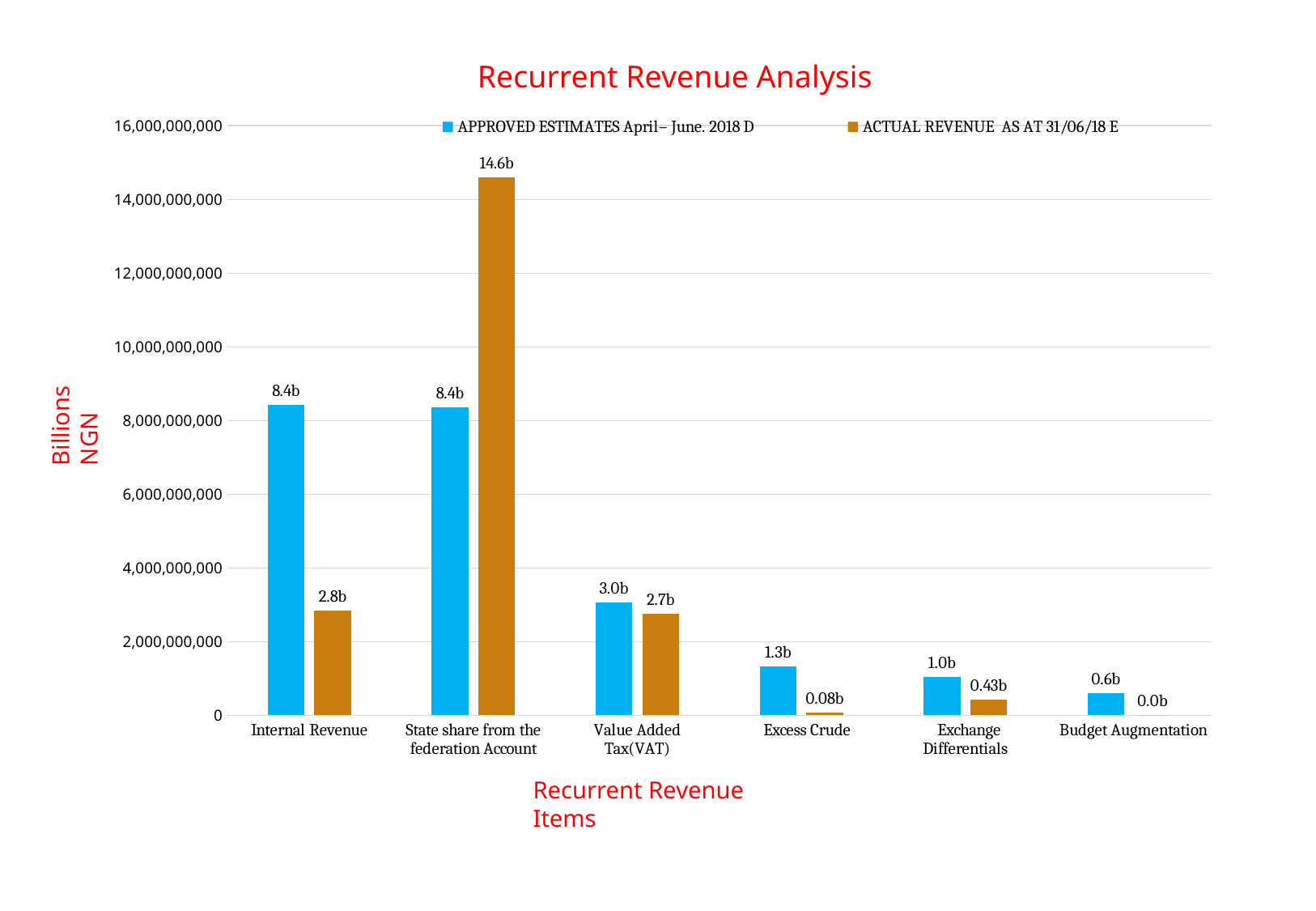
What is the actual revenue for Excess Crude? 0.08b Which recurrent revenue item has the highest actual revenue? State share from the federation Account What is the difference between the actual revenue and the approved estimate for State share from the federation Account? 6.2b What is the approved estimate for Internal Revenue? 8.4b How many recurrent revenue items are shown on the x axis? 6 What kind of chart is shown on the slide? Bar chart For Internal Revenue, which is larger: the approved estimate or the actual revenue? Approved estimate Is the actual revenue for State share from the federation Account greater or less than 14,000,000,000? greater What is the actual revenue as at 31/06/18 for State share from the federation Account? 14.6b How many series does the legend list? 2 What is the approved estimate for Exchange Differentials? 1.0b Which recurrent revenue item has the lowest approved estimate? Budget Augmentation